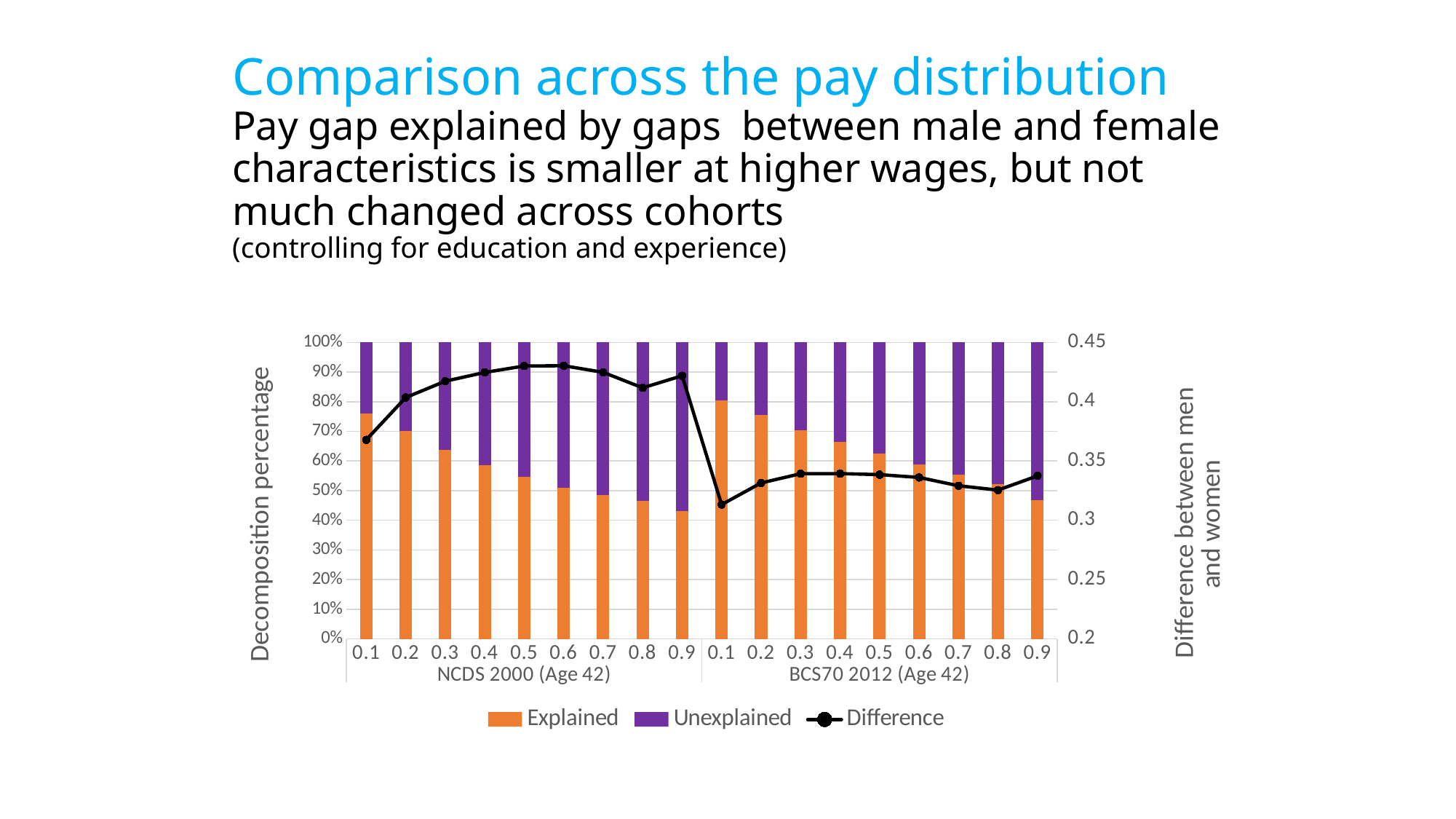
What kind of chart is shown on the slide? A stacked bar chart combined with a line Within the NCDS 2000 (Age 42) cohort, at which decile is the Explained share highest? 0.1 Is the Explained share for decile 0.1 in NCDS 2000 greater or less than 70%? greater How many stacked bars are plotted in total across both cohorts? 18 What is the total height of each stacked bar on the left axis? 100% Is the Difference value for decile 0.1 in BCS70 2012 greater or less than 0.35? less Within the BCS70 2012 (Age 42) cohort, at which decile is the Explained share lowest? 0.9 Across the deciles of the NCDS 2000 (Age 42) cohort, does the Explained share rise or fall from 0.1 to 0.9? fall What are the three series named in the legend? Explained, Unexplained, Difference Which is larger: the Difference value at decile 0.5 for NCDS 2000 or at decile 0.5 for BCS70 2012? NCDS 2000 How many series does the legend list? 3 How many deciles are shown for the NCDS 2000 (Age 42) cohort? 9